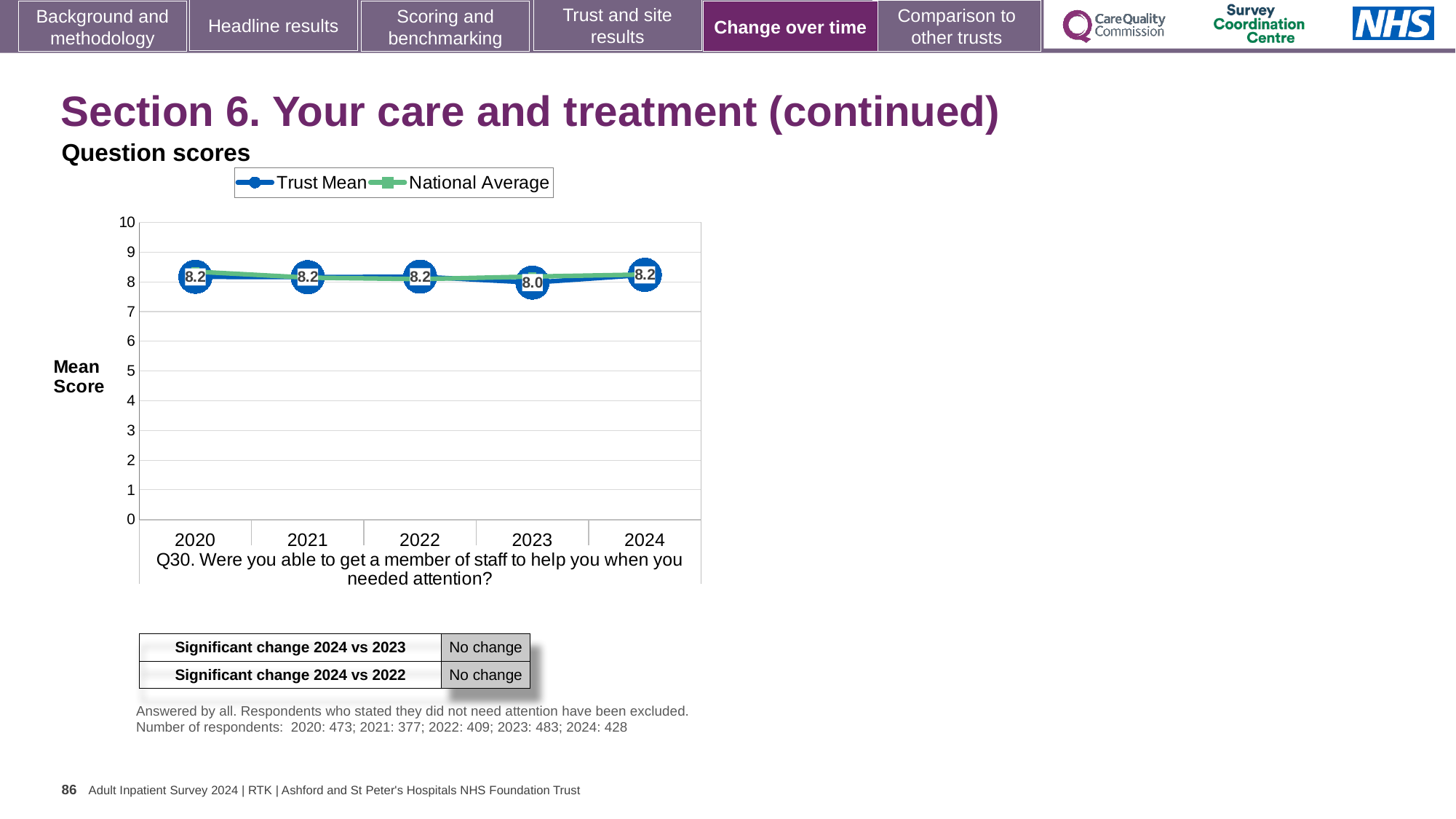
What kind of chart is shown on the slide? Line chart Is the National Average value for 2023 greater or less than 7? greater What are the two series named in the legend? Trust Mean and National Average Which is larger, the Trust Mean score for 2022 or for 2023? 2022 Is the Trust Mean value for 2021 greater or less than 9? less In which year is the Trust Mean score lowest? 2023 What is the Trust Mean score for 2020? 8.2 How many series does the legend list? 2 What is the difference between the Trust Mean score in 2024 and in 2023? 0.2 What is the Trust Mean score for 2023? 8.0 What is the Trust Mean score for 2024? 8.2 How many years are plotted on the x axis? 5